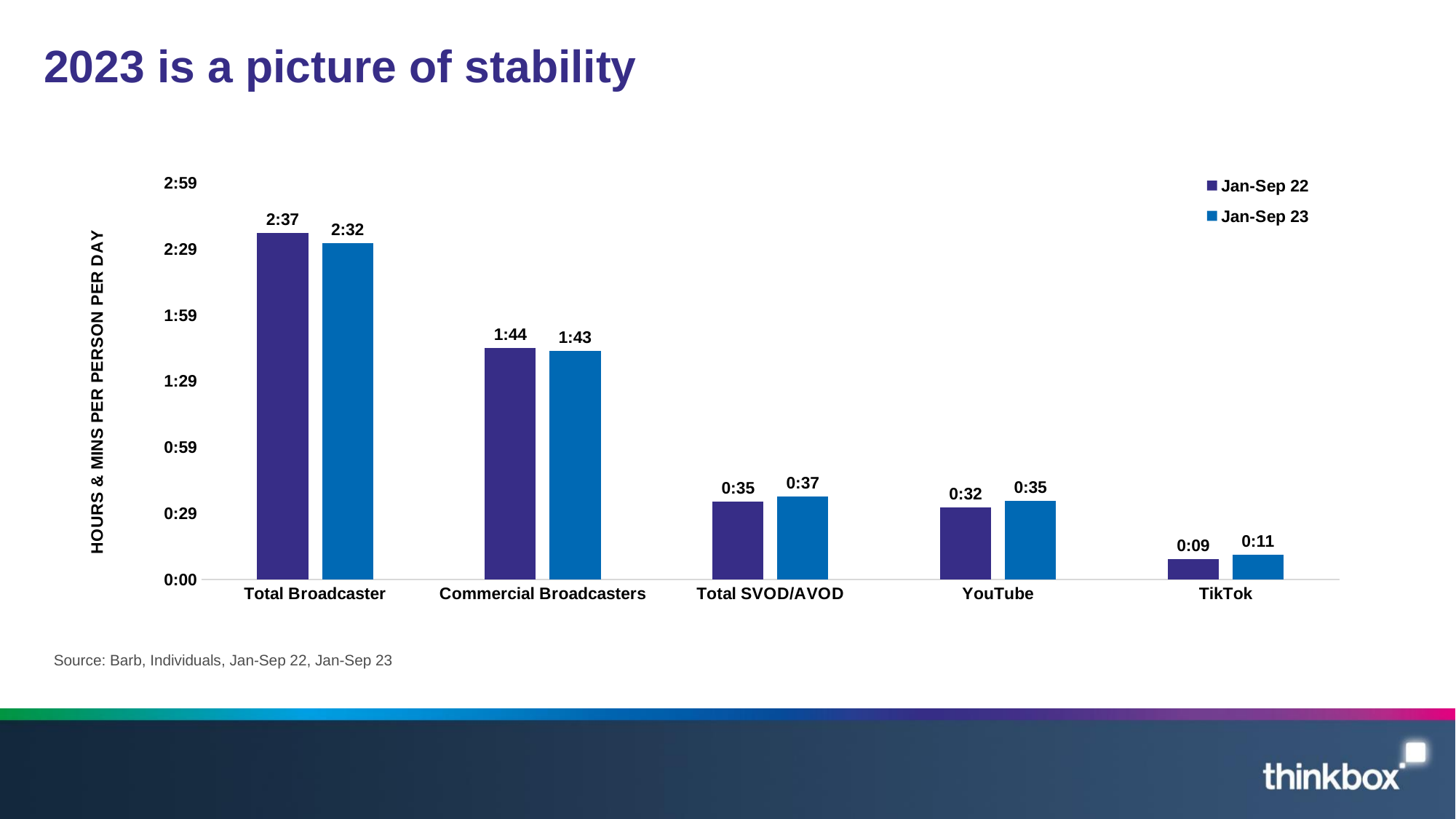
Which is larger for Total SVOD/AVOD: the Jan-Sep 22 value or the Jan-Sep 23 value? Jan-Sep 23 What is the Jan-Sep 23 value for Total Broadcaster? 2:32 What is the Jan-Sep 22 value for YouTube? 0:32 What is the difference between the Jan-Sep 22 and Jan-Sep 23 values for Total Broadcaster? 0:05 Which category has the highest Jan-Sep 23 value? Total Broadcaster What is the Jan-Sep 23 value for TikTok? 0:11 Is the Jan-Sep 23 value for Commercial Broadcasters greater or less than 1:29? greater What is the Jan-Sep 22 value for Commercial Broadcasters? 1:44 What kind of chart is shown on the slide? Bar chart Which category has the lowest Jan-Sep 22 value? TikTok How many series does the legend list? 2 How many categories are shown on the x axis? 5